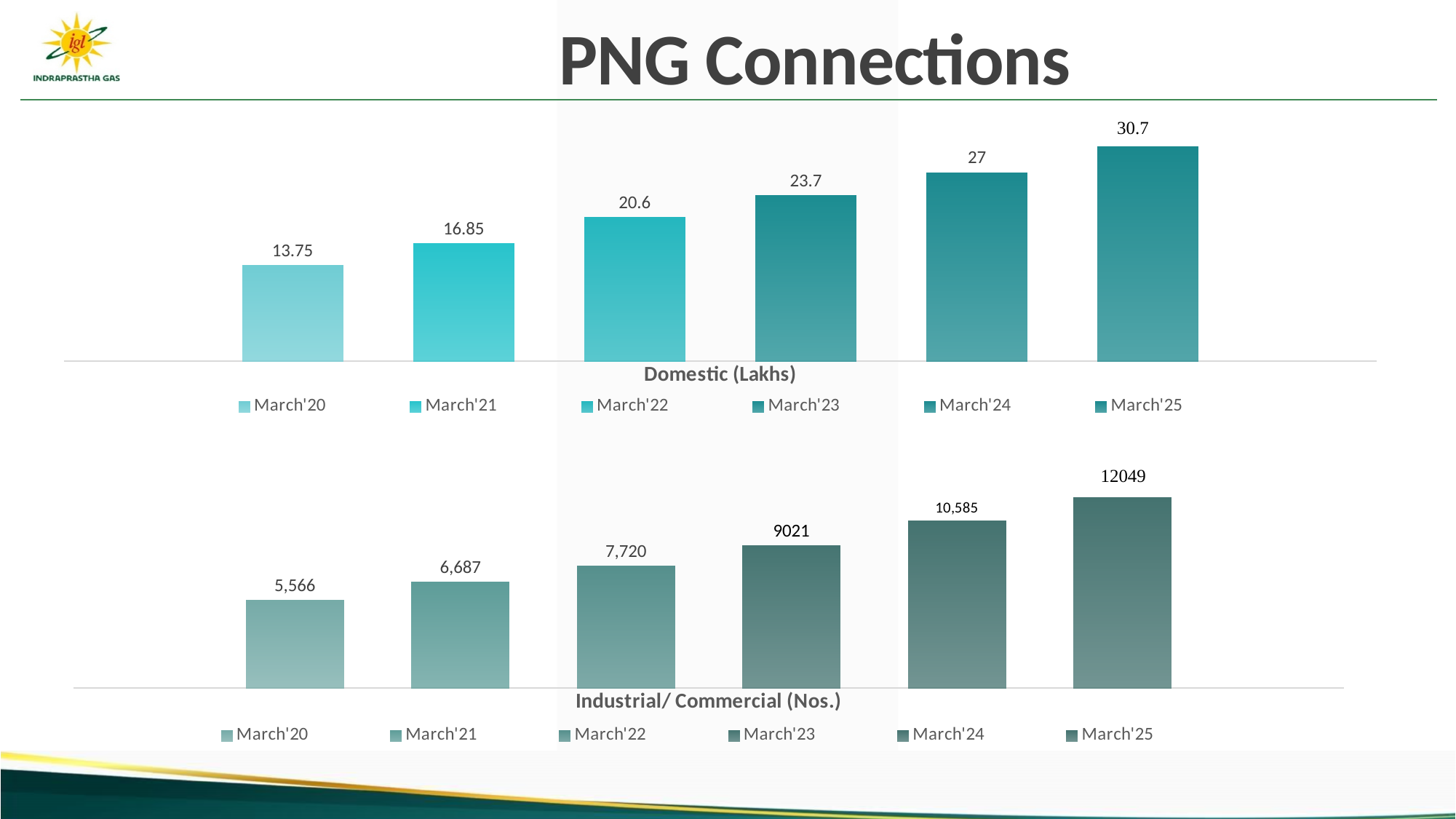
In the Industrial/ Commercial (Nos.) chart, what is the difference between the March'23 and March'22 values? 1,301 In the Industrial/ Commercial (Nos.) chart, what is the value for March'21? 6,687 In the Industrial/ Commercial (Nos.) chart, do the values rise or fall from March'20 to March'25? Rise In the Industrial/ Commercial (Nos.) chart, which year has the highest value? March'25 In the Industrial/ Commercial (Nos.) chart, what is the value for March'24? 10,585 In the Domestic (Lakhs) chart, what is the value for March'22? 20.6 In the Domestic (Lakhs) chart, which is larger: the value for March'21 or March'23? March'23 How many bars are shown in the Industrial/ Commercial (Nos.) chart? 6 In the Domestic (Lakhs) chart, what is the value for March'25? 30.7 In the Domestic (Lakhs) chart, which year has the lowest value? March'20 What kind of chart is the Domestic (Lakhs) chart? Bar chart In the Domestic (Lakhs) chart, what is the difference between the March'25 and March'24 values? 3.7